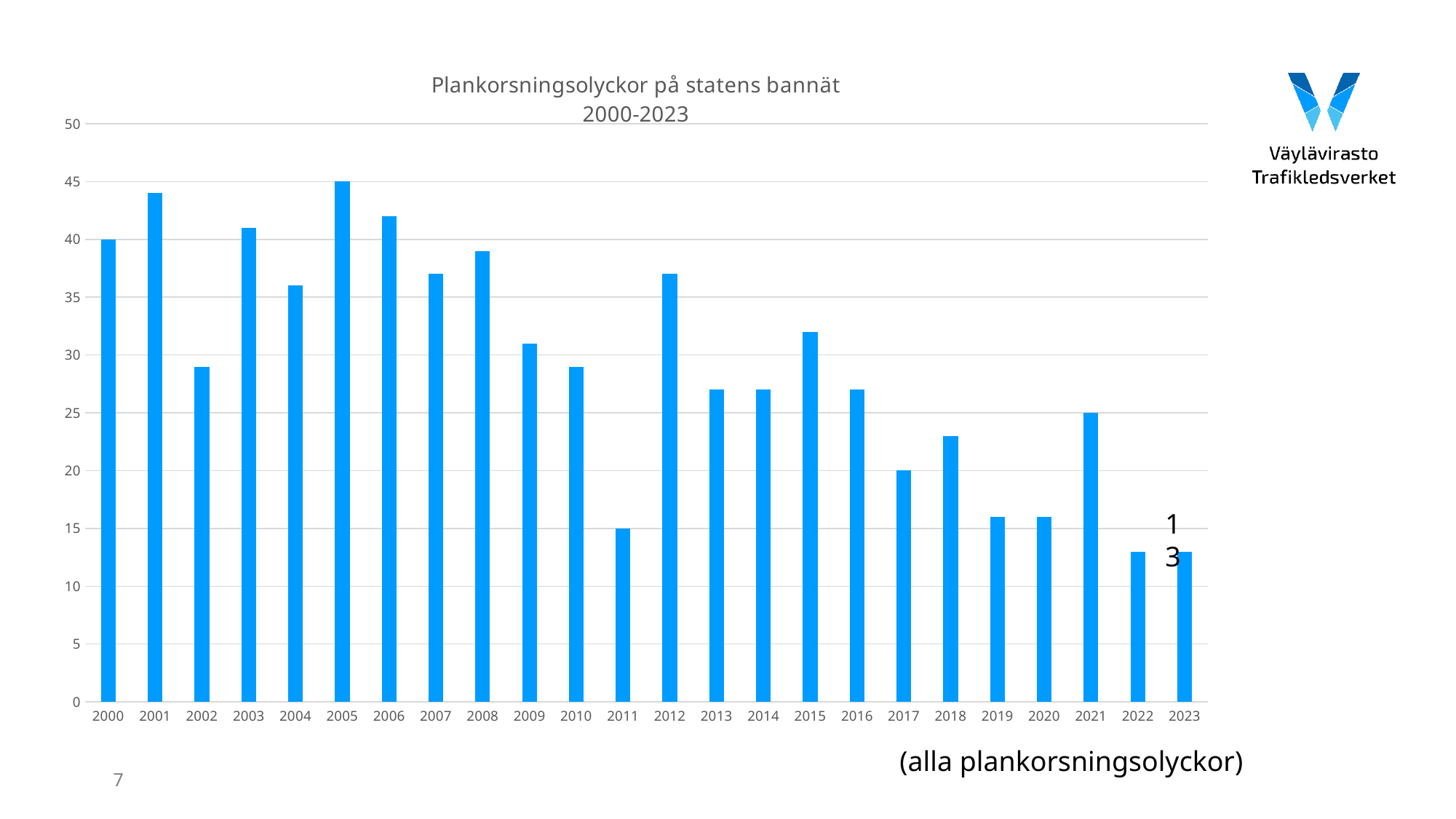
What is the title of the chart? Plankorsningsolyckor på statens bannät 2000-2023 Which year has the highest bar in the chart? 2005 Is the value for 2019 greater or less than 20? less What is the value for 2023 according to the label on the chart? 13 What is the value for 2011? 15 Is the value for 2001 greater or less than 40? greater How many years are plotted on the x axis of the chart? 24 What is the difference between the values for 2005 and 2011? 30 What kind of chart is shown on the slide? bar chart Do the values generally rise or fall from 2000 to 2023? fall What is the value for 2005? 45 Which year has the larger value, 2006 or 2010? 2006